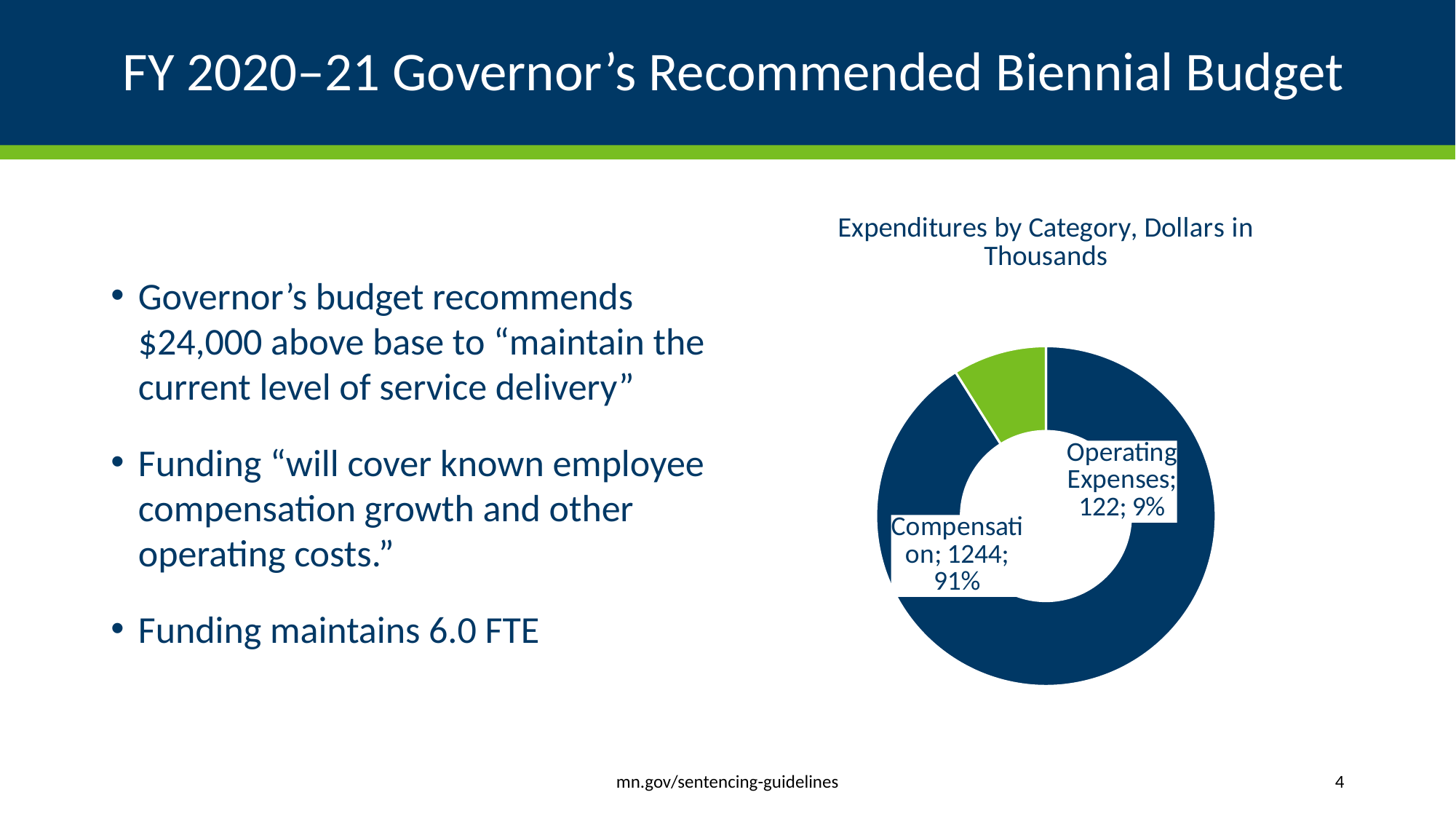
Which is larger, Compensation or Operating Expenses? Compensation What share of the pie does Compensation represent? 91% Which category has the largest value in the Expenditures by Category chart? Compensation What is the title of the chart on the slide? Expenditures by Category, Dollars in Thousands Which category has the smallest value in the Expenditures by Category chart? Operating Expenses What is the value for Operating Expenses in the Expenditures by Category chart? 122 What is the difference between the Compensation value and the Operating Expenses value? 1122 What kind of chart is shown on the slide? Pie chart (doughnut) What colour is the Operating Expenses slice in the chart? Green What share of the pie does Operating Expenses represent? 9% How many categories are shown in the Expenditures by Category chart? 2 What is the value for Compensation in the Expenditures by Category chart? 1244